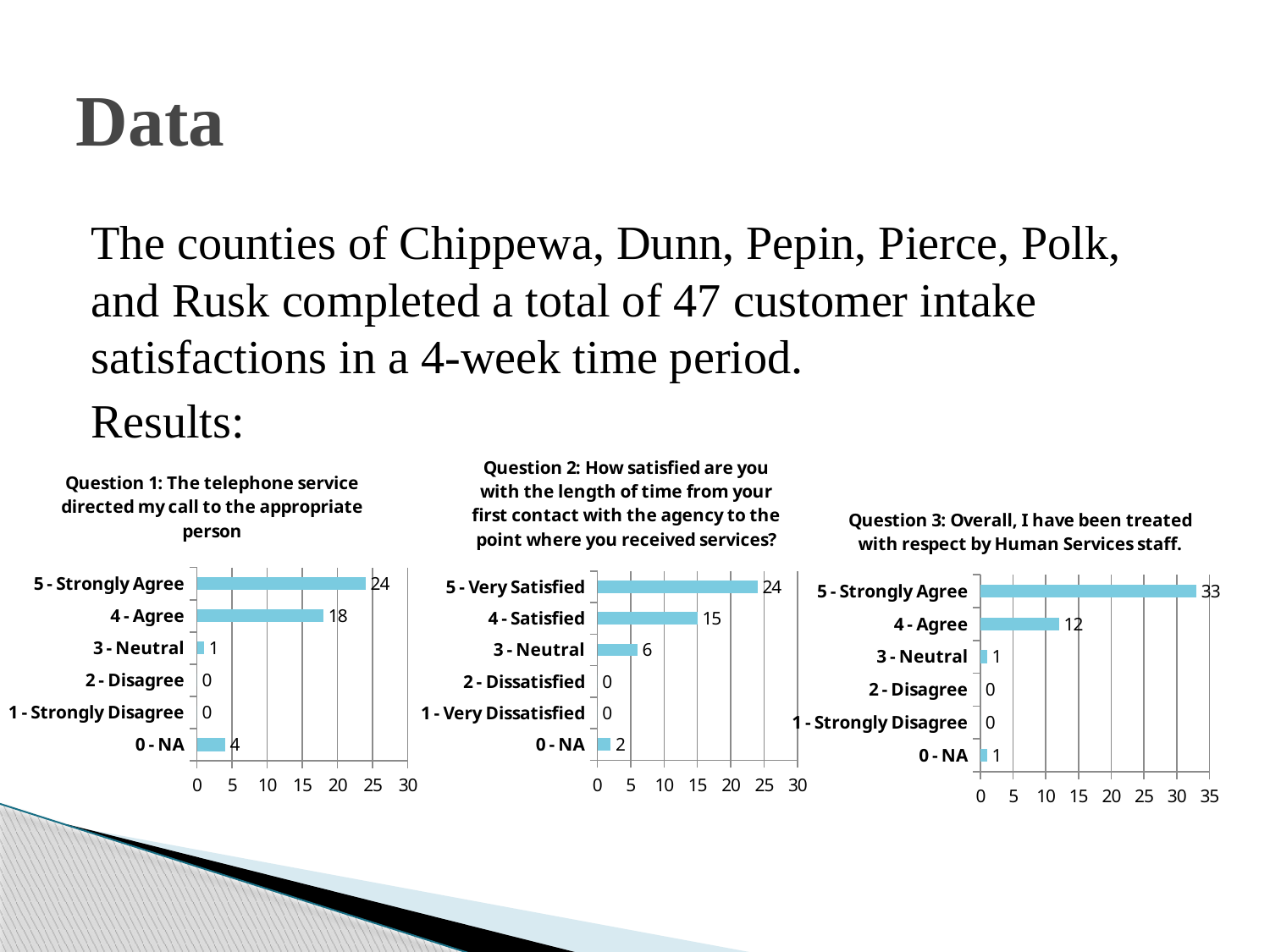
In the Question 1 chart, what is the value for 5 - Strongly Agree? 24 In the Question 3 chart, which category has the highest value? 5 - Strongly Agree In the Question 3 chart, what is the value for 4 - Agree? 12 In the Question 1 chart, what is the value for 0 - NA? 4 How many charts are shown on the slide? 3 What kind of chart is the Question 1 chart? bar chart In the Question 2 chart, what is the value for 3 - Neutral? 6 In the Question 2 chart, what is the difference between 5 - Very Satisfied and 4 - Satisfied? 9 In the Question 3 chart, is the value for 5 - Strongly Agree greater or less than 30? greater How many categories are shown in the Question 2 chart? 6 In the Question 1 chart, what is the difference between 5 - Strongly Agree and 4 - Agree? 6 In the Question 1 chart, which is larger, 4 - Agree or 0 - NA? 4 - Agree